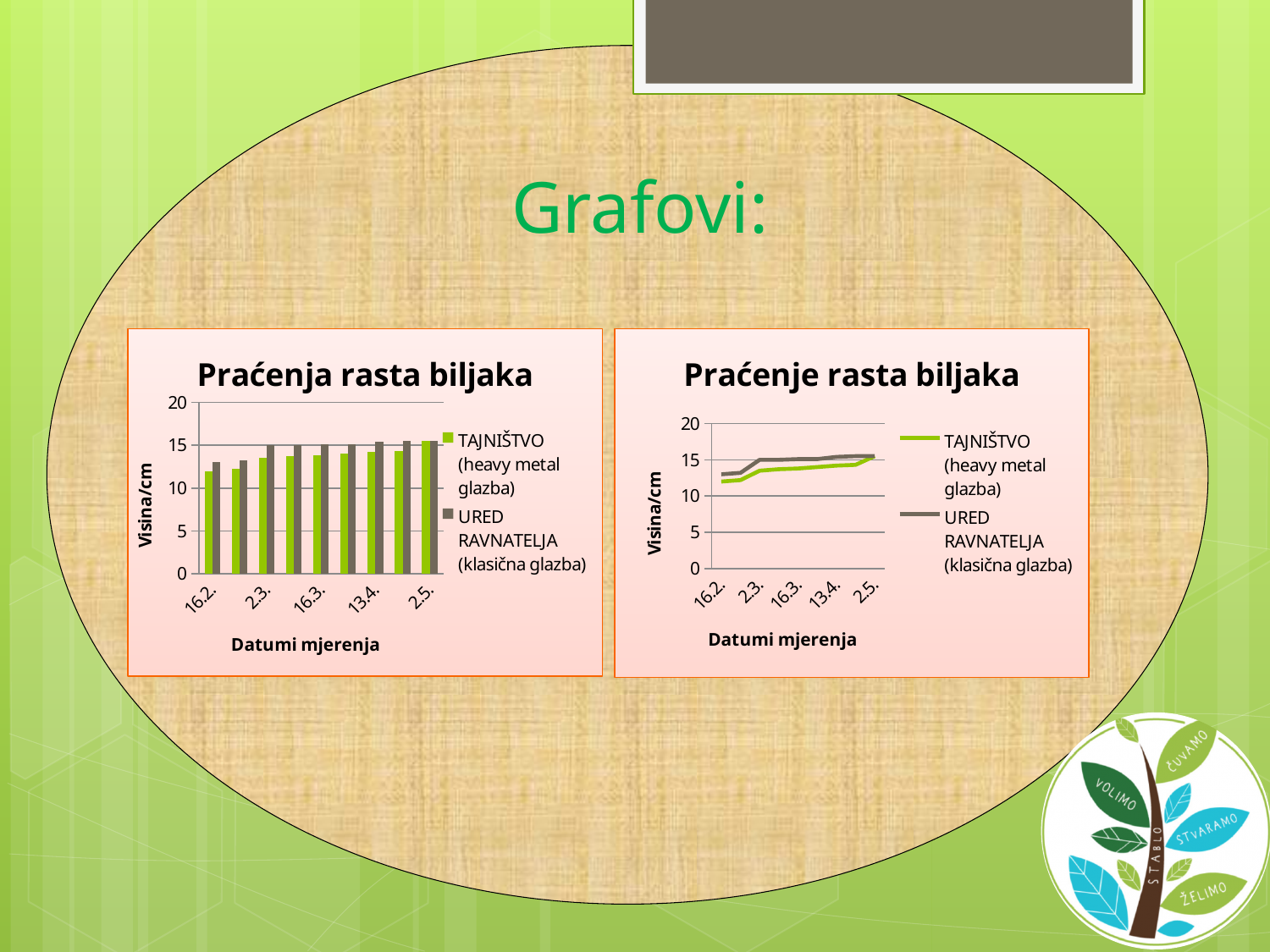
What is the x-axis label of the right line chart? Datumi mjerenja In the left bar chart, is the value for TAJNIŠTVO (heavy metal glazba) at 16.2. greater or less than 10? greater In the right line chart, do the values for TAJNIŠTVO (heavy metal glazba) rise or fall from 16.2. to 2.5.? rise What is the y-axis label of the left bar chart? Visina/cm In the left bar chart, how many series does the legend list? 2 In the right line chart, is the value for URED RAVNATELJA (klasična glazba) at 16.2. greater or less than 15? less In the left bar chart, do the values for URED RAVNATELJA (klasična glazba) generally rise or fall along the x axis? rise In the left bar chart, which series has the higher value at 2.3.: TAJNIŠTVO (heavy metal glazba) or URED RAVNATELJA (klasična glazba)? URED RAVNATELJA (klasična glazba) What kind of chart is the left chart titled "Praćenja rasta biljaka"? bar chart In the left bar chart, is the value for TAJNIŠTVO (heavy metal glazba) at 16.2. greater or less than 15? less In the right line chart, how many series does the legend list? 2 What kind of chart is the right chart titled "Praćenje rasta biljaka"? line chart